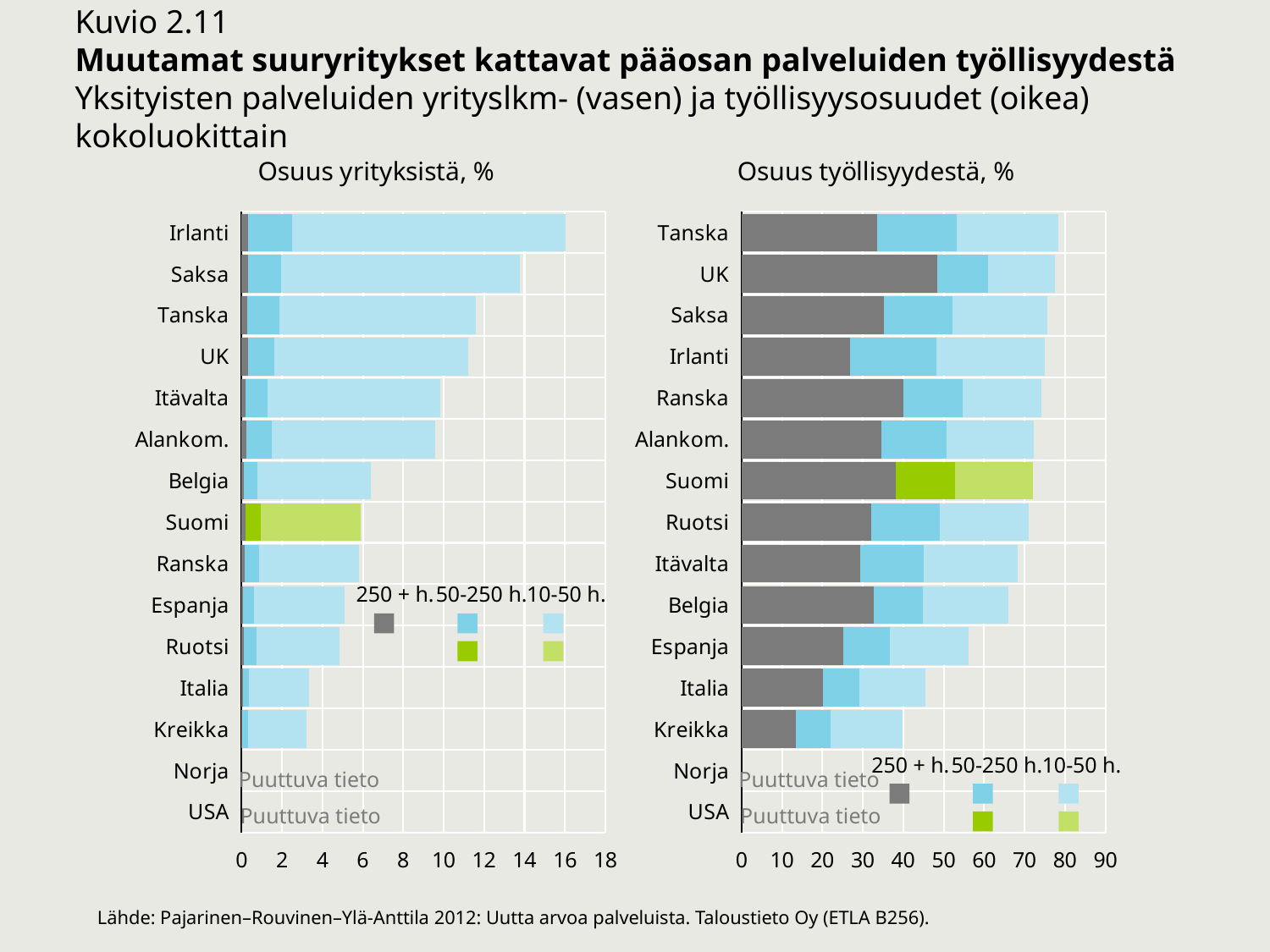
How many series does the legend of the right chart "Osuus työllisyydestä, %" list? 3 In the right chart "Osuus työllisyydestä, %", which country has the shortest total bar among those with data? Kreikka In the left chart "Osuus yrityksistä, %", which country has the longest total bar? Irlanti In the left chart "Osuus yrityksistä, %", is the total bar for Kreikka greater or less than 4? less In the right chart "Osuus työllisyydestä, %", which country has the largest "250 + h." segment? UK In the right chart "Osuus työllisyydestä, %", is the total bar for Kreikka greater or less than 50? less What kind of chart is the left chart titled "Osuus yrityksistä, %"? bar chart In the right chart "Osuus työllisyydestä, %", is the total bar for Tanska greater or less than 70? greater In the left chart "Osuus yrityksistä, %", which total bar is longer, Irlanti or Saksa? Irlanti In the right chart "Osuus työllisyydestä, %", which total bar is longer, Irlanti or Espanja? Irlanti Which two countries are marked "Puuttuva tieto" (missing data) in both charts? Norja and USA